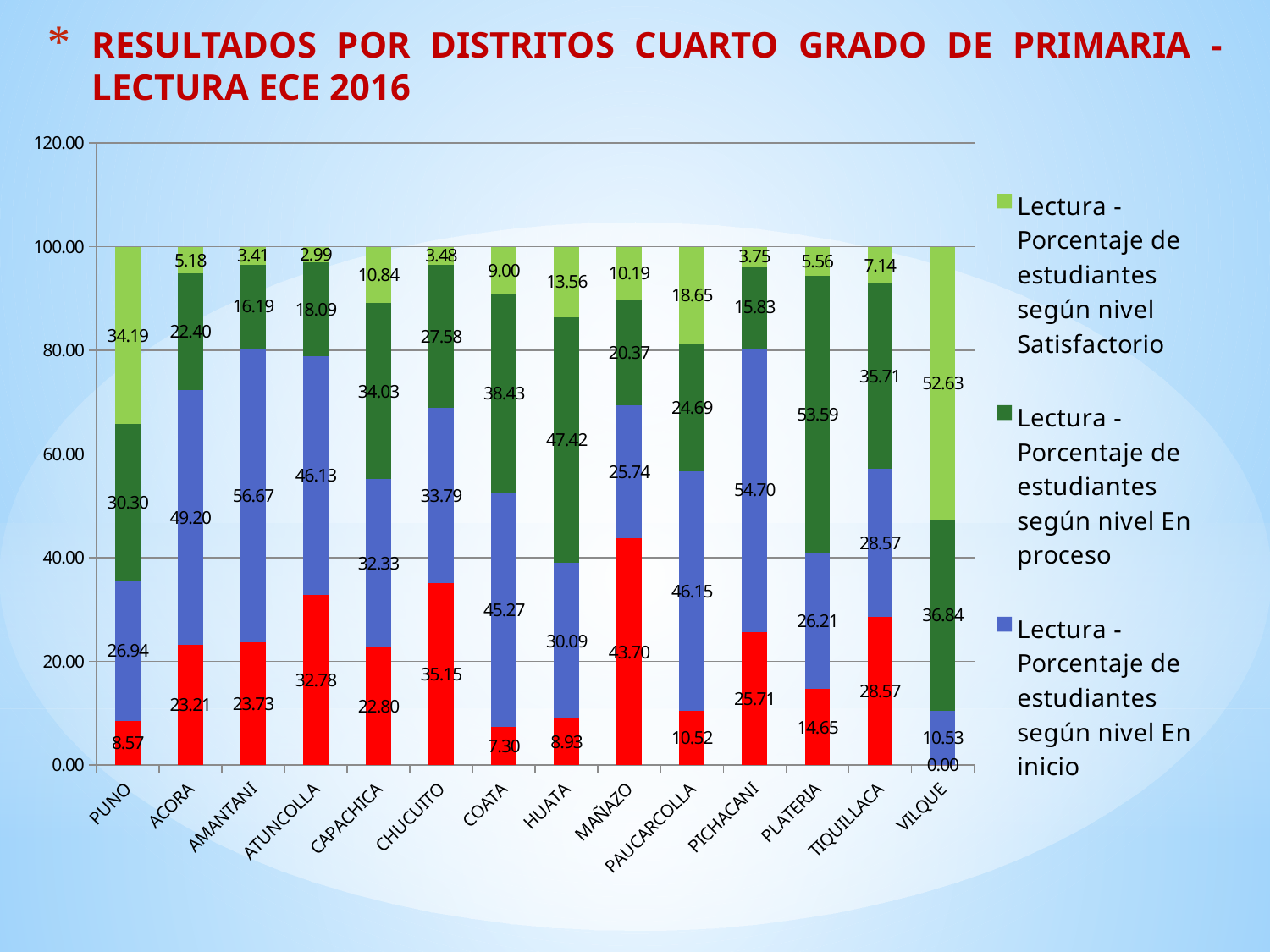
What is the difference between the 'nivel Satisfactorio' values for VILQUE and PUNO? 18.44 What is the value for HUATA in the 'Lectura - Porcentaje de estudiantes según nivel En proceso' series? 47.42 Which district has the highest value in the 'nivel En proceso' series? PLATERIA Which district has the highest value in the 'nivel Satisfactorio' series? VILQUE How many districts are shown on the x axis? 14 What is the value for VILQUE in the 'Lectura - Porcentaje de estudiantes según nivel Satisfactorio' series? 52.63 What is the title of the slide? RESULTADOS POR DISTRITOS CUARTO GRADO DE PRIMARIA - LECTURA ECE 2016 Which district has the lowest value in the 'nivel Satisfactorio' series? ATUNCOLLA How many series does the legend list? 3 What is the value for ACORA in the 'Lectura - Porcentaje de estudiantes según nivel En inicio' series? 49.20 What kind of chart is shown on the slide? Stacked bar chart Which district has a larger 'nivel En inicio' value, AMANTANI or PICHACANI? AMANTANI